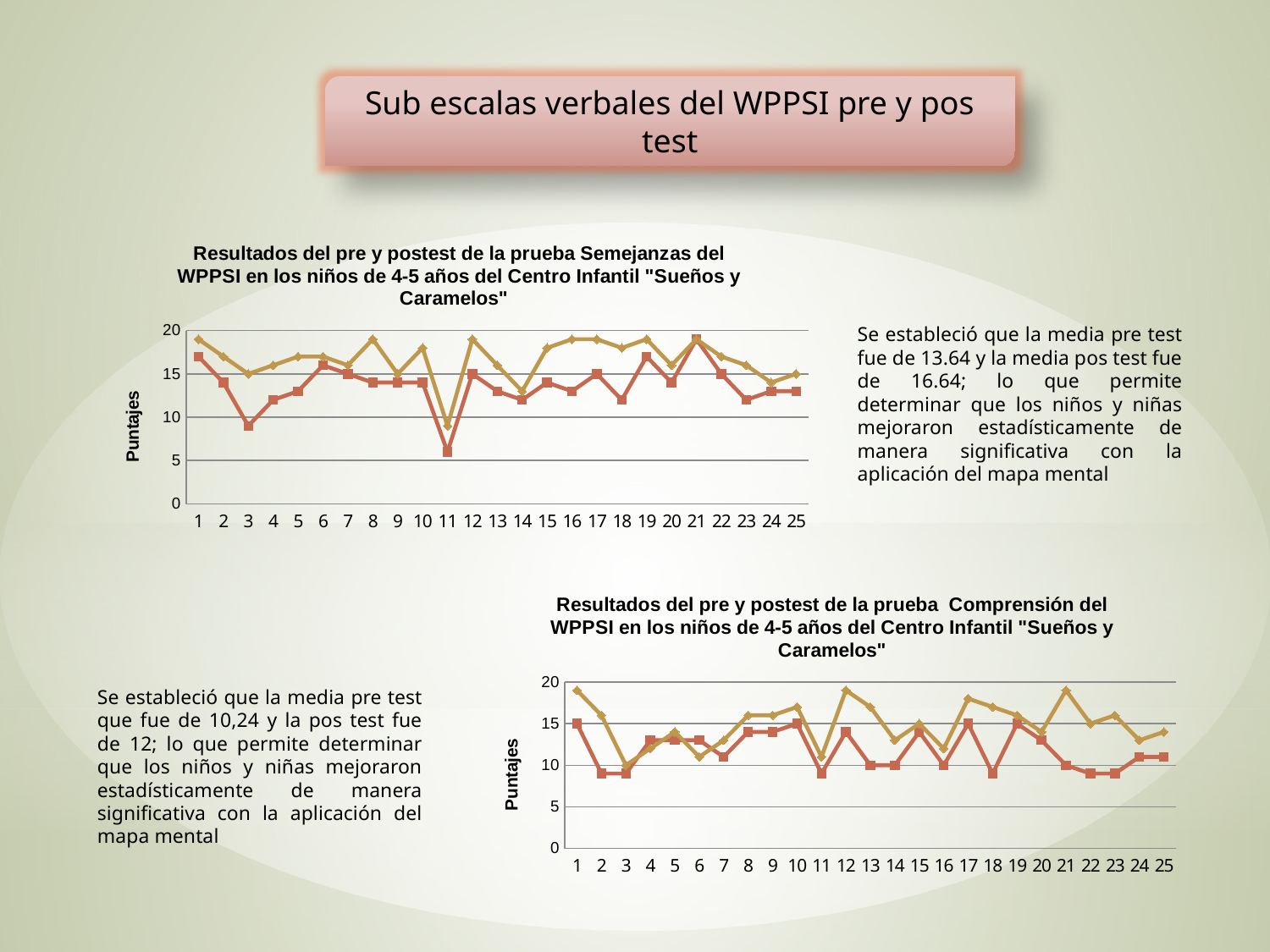
In the top chart (prueba Semejanzas), at point 3, which line has the higher value, the gold line or the red line? gold line In the top chart (prueba Semejanzas), how many points are shown along the x axis? 25 In the bottom chart (prueba Comprensión), at point 2, which line has the higher value, the gold line or the red line? gold line What type of chart is the top chart titled "Resultados del pre y postest de la prueba Semejanzas"? line chart What type of chart is the bottom chart titled "Resultados del pre y postest de la prueba Comprensión"? line chart In the top chart (prueba Semejanzas), is the value of the gold line at point 1 greater or less than 15? greater In the top chart (prueba Semejanzas), at which x-axis point does the red line reach its lowest value? 11 In the bottom chart (prueba Comprensión), how many points are shown along the x axis? 25 In the top chart (prueba Semejanzas), what is the title of the y axis? Puntajes In the bottom chart (prueba Comprensión), is the value of the gold line at point 12 greater or less than 15? greater In the top chart (prueba Semejanzas), how many lines (data series) are plotted? 2 In the top chart (prueba Semejanzas), is the value of the red line at point 11 greater or less than 10? less